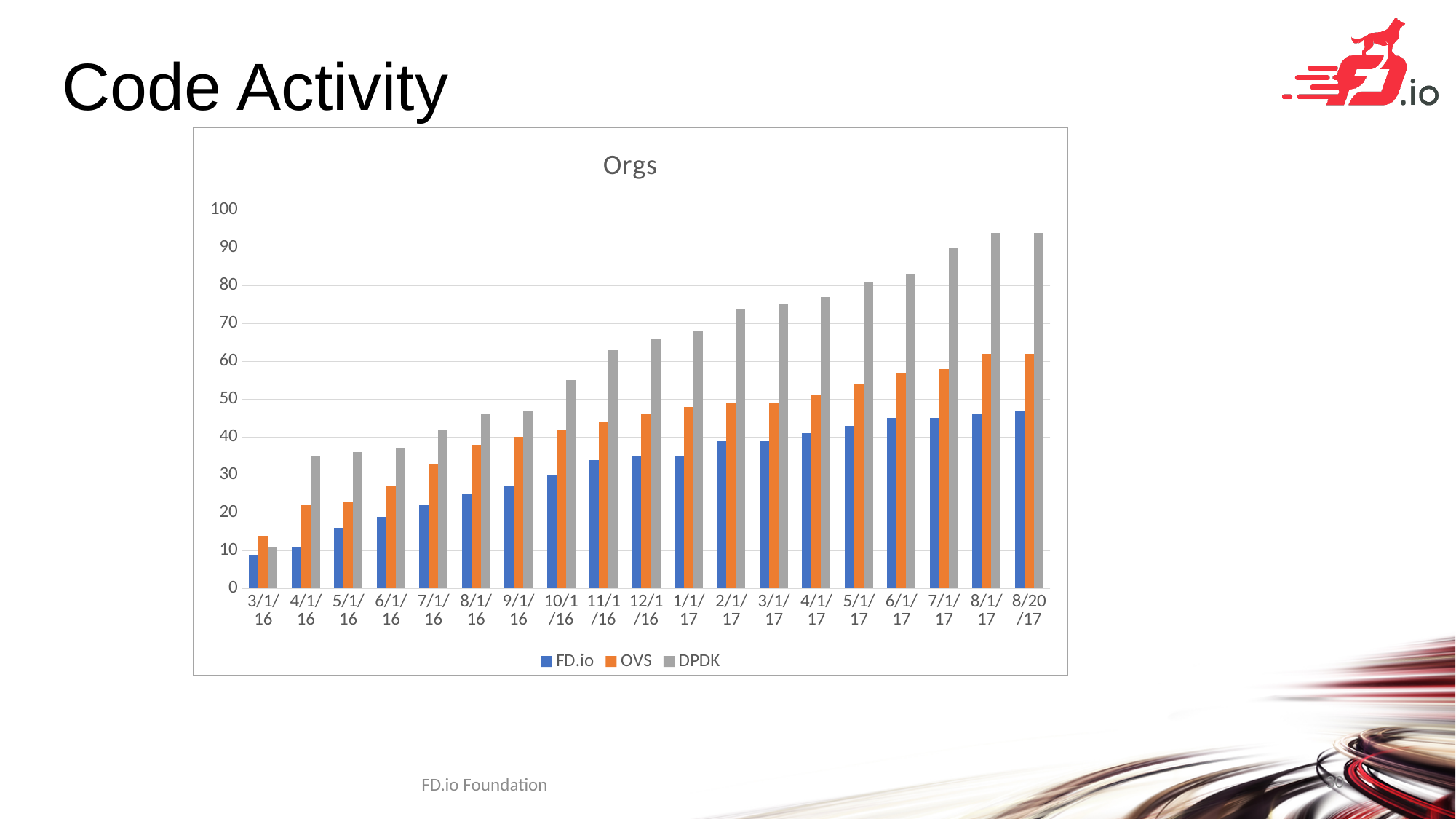
How many series does the legend list? 3 Is the OVS value for 8/20/17 greater or less than 60? greater What is the title of the chart? Orgs Do the DPDK values generally rise or fall from 3/1/16 to 8/20/17? rise Which series has the lowest value at 3/1/16? FD.io At 3/1/16, which is larger: the OVS value or the DPDK value? OVS Which series has the highest value at 8/20/17? DPDK Is the DPDK value for 8/1/17 greater or less than 90? greater What kind of chart is shown on the slide? bar chart Is the FD.io value for 8/20/17 greater or less than 50? less How many dates are shown along the x axis? 19